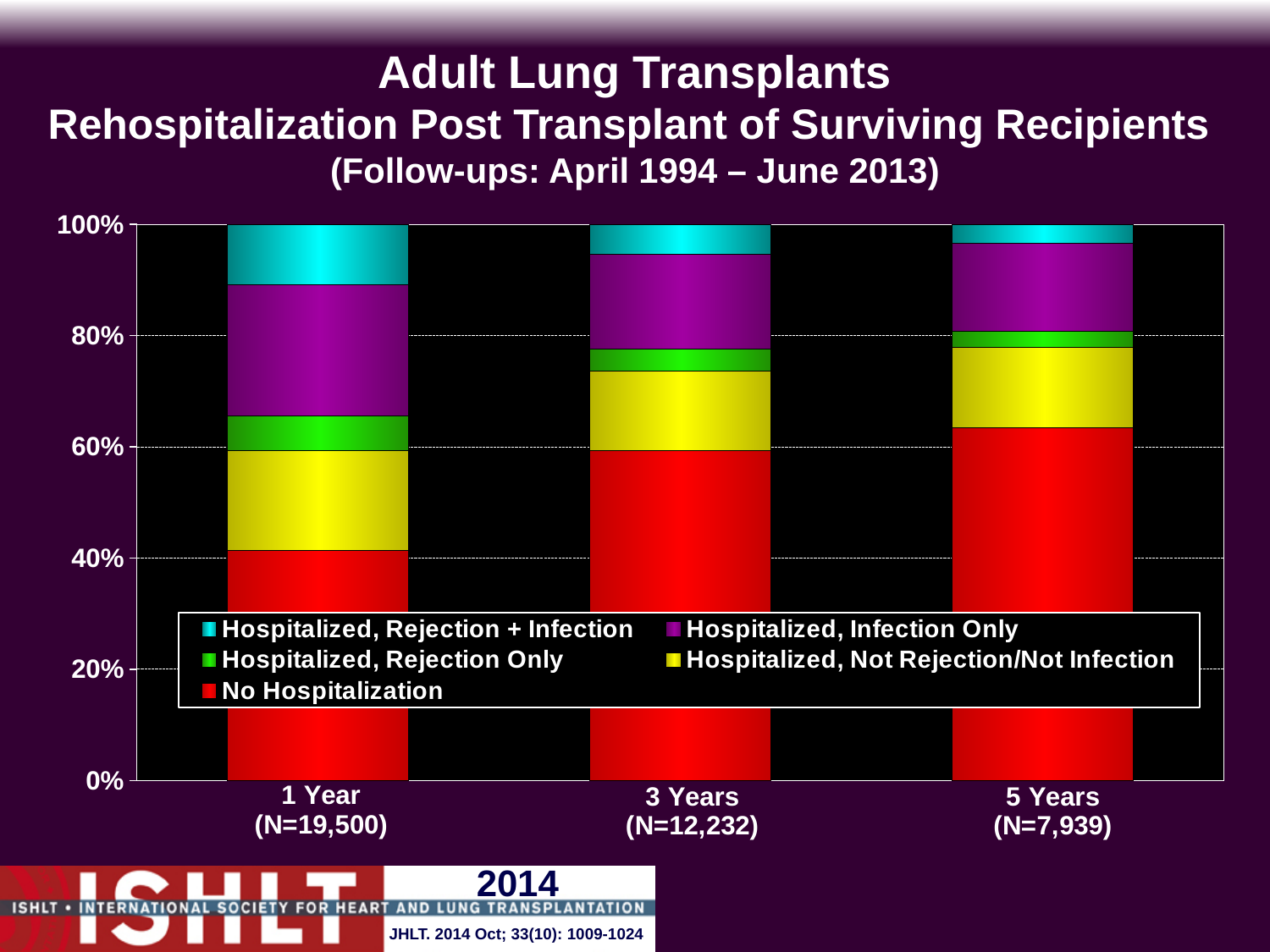
Is the No Hospitalization share at 1 Year greater or less than 60%? less How many time-point categories are shown on the x axis? 3 What kind of chart is shown on the slide? Stacked bar chart What is the N shown for the 1 Year category? N=19,500 Is the No Hospitalization share at 3 Years greater or less than 40%? greater Is the No Hospitalization share larger at 1 Year or at 3 Years? 3 Years Which time point has the smallest No Hospitalization share? 1 Year Is the No Hospitalization share at 5 Years greater or less than 40%? greater Is the Hospitalized, Infection Only share larger at 1 Year or at 5 Years? 1 Year How many series does the legend list? 5 Does the No Hospitalization share rise or fall from 1 Year to 5 Years? rise Which time point has the largest No Hospitalization share? 5 Years